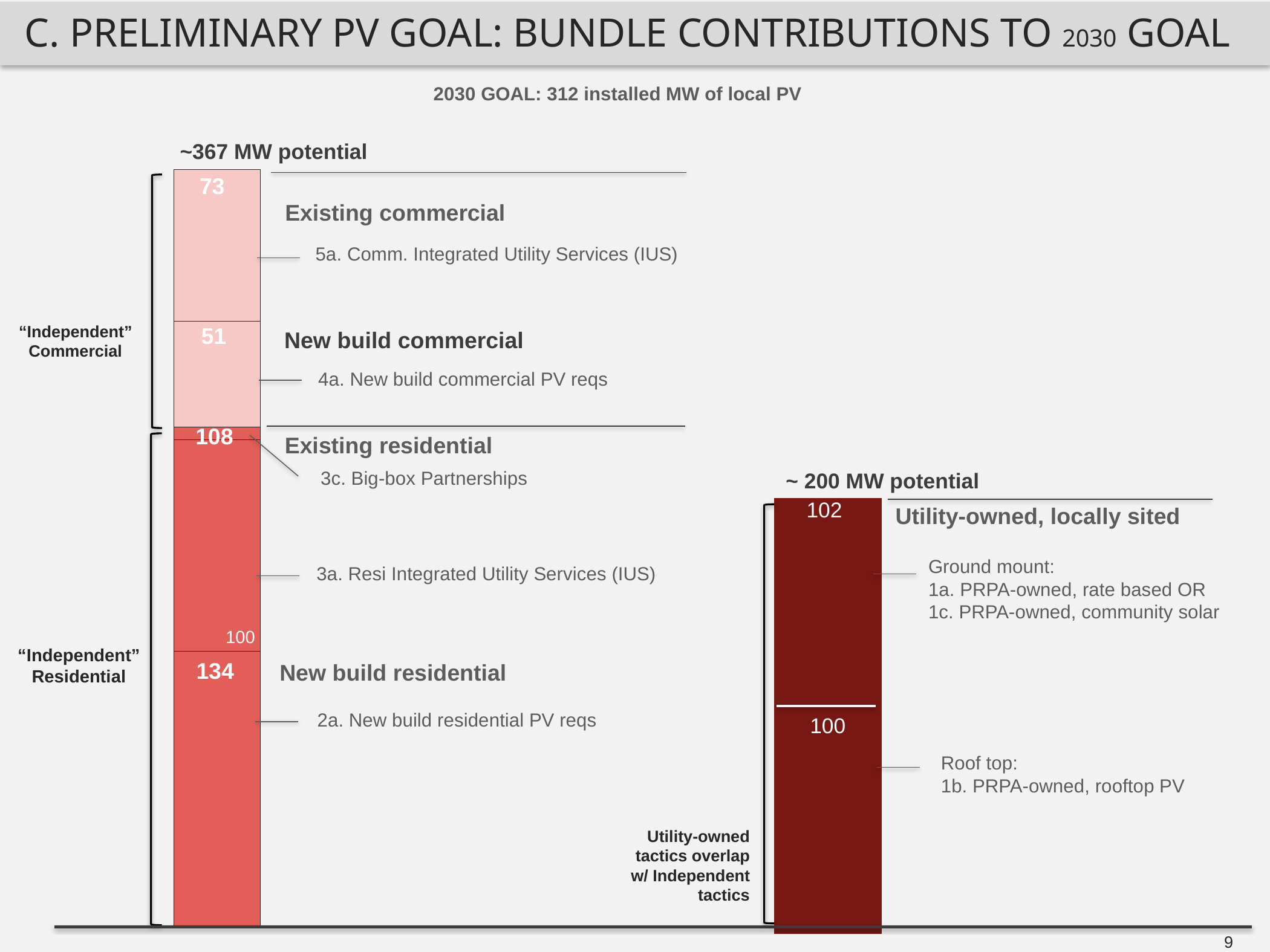
In the left stacked bar, what value is shown for the Existing commercial segment? 73 In the left stacked bar, what is the total of the two "Independent" Commercial segments (Existing commercial and New build commercial)? 124 In the left stacked bar, which segment has the largest value? New build residential In the left stacked bar, which is larger: Existing commercial or New build commercial? Existing commercial In the right stacked bar (Utility-owned, locally sited), what value is shown for the Ground mount segment? 102 How many segments make up the left stacked bar? 4 In the left stacked bar, which segment has the smallest value? New build commercial In the left stacked bar, what value is shown for the New build commercial segment? 51 In the left stacked bar, what value is shown for the New build residential segment? 134 In the left stacked bar, what value is shown for the Existing residential segment? 108 In the left stacked bar, what is the difference between the New build residential and Existing residential values? 26 In the right stacked bar (Utility-owned, locally sited), what value is shown for the Roof top segment? 100